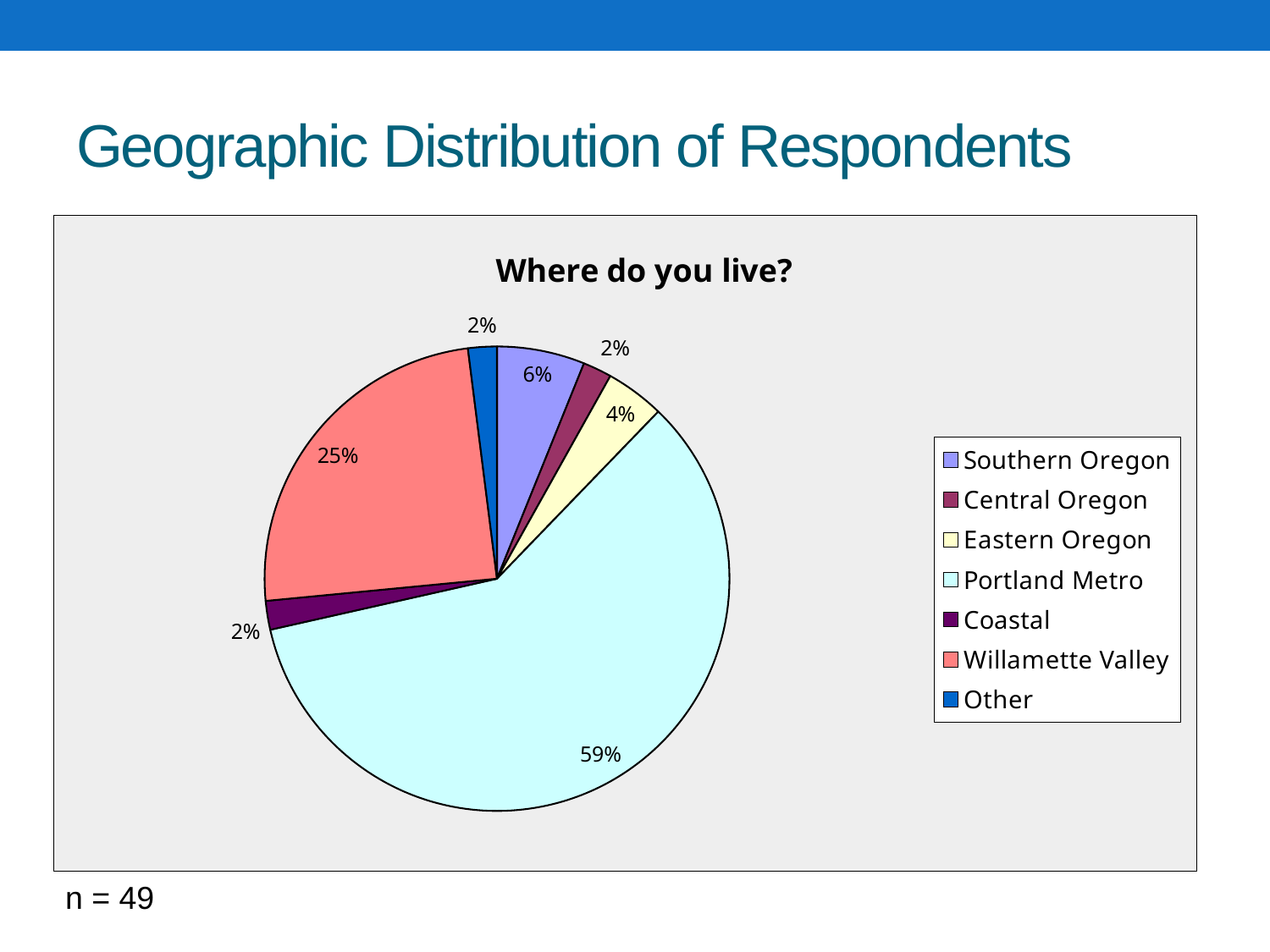
What is the title of the chart? Where do you live? How many regions are listed in the legend? 7 What type of chart is shown on the slide? Pie chart What share of respondents live in Eastern Oregon? 4% Which region has the largest share of respondents? Portland Metro What is the sample size (n) stated on the slide? 49 What is the difference in percentage points between the Portland Metro share and the Willamette Valley share? 34 What share of respondents live in Southern Oregon? 6% Which has a larger share of respondents, Southern Oregon or Eastern Oregon? Southern Oregon What share of respondents live in the Willamette Valley? 25%